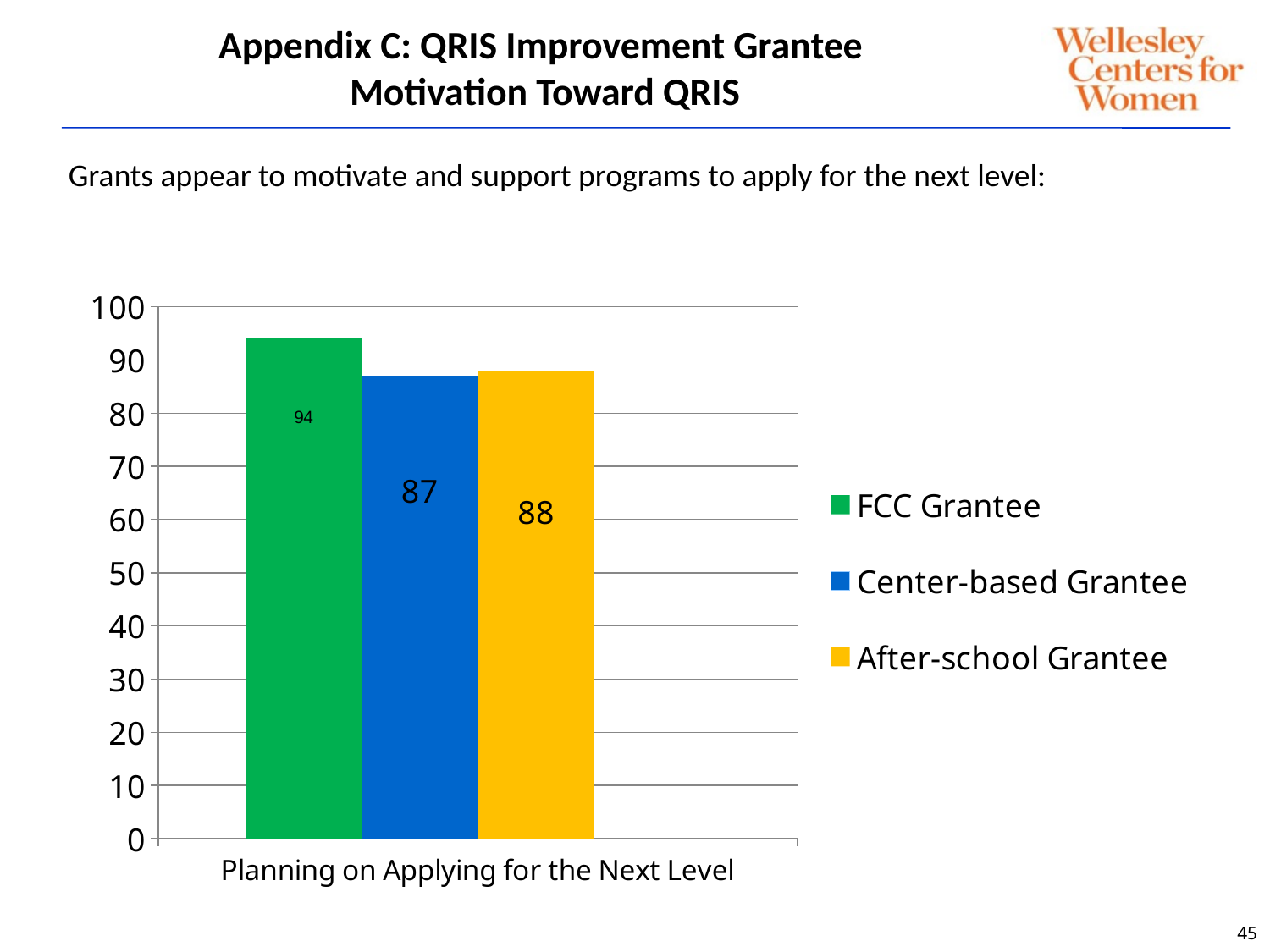
Which series has the lowest value? Center-based Grantee What is the value for FCC Grantee? 94 How many series does the legend list? 3 Which is larger, the value for FCC Grantee or the value for After-school Grantee? FCC Grantee Is the value for Center-based Grantee greater or less than 90? less What is the value for Center-based Grantee? 87 What is the value for After-school Grantee? 88 What is the difference between the FCC Grantee value and the Center-based Grantee value? 7 What is the category label shown on the x axis? Planning on Applying for the Next Level What kind of chart is shown on the slide? bar chart Which series has the highest value? FCC Grantee What is the difference between the After-school Grantee value and the Center-based Grantee value? 1